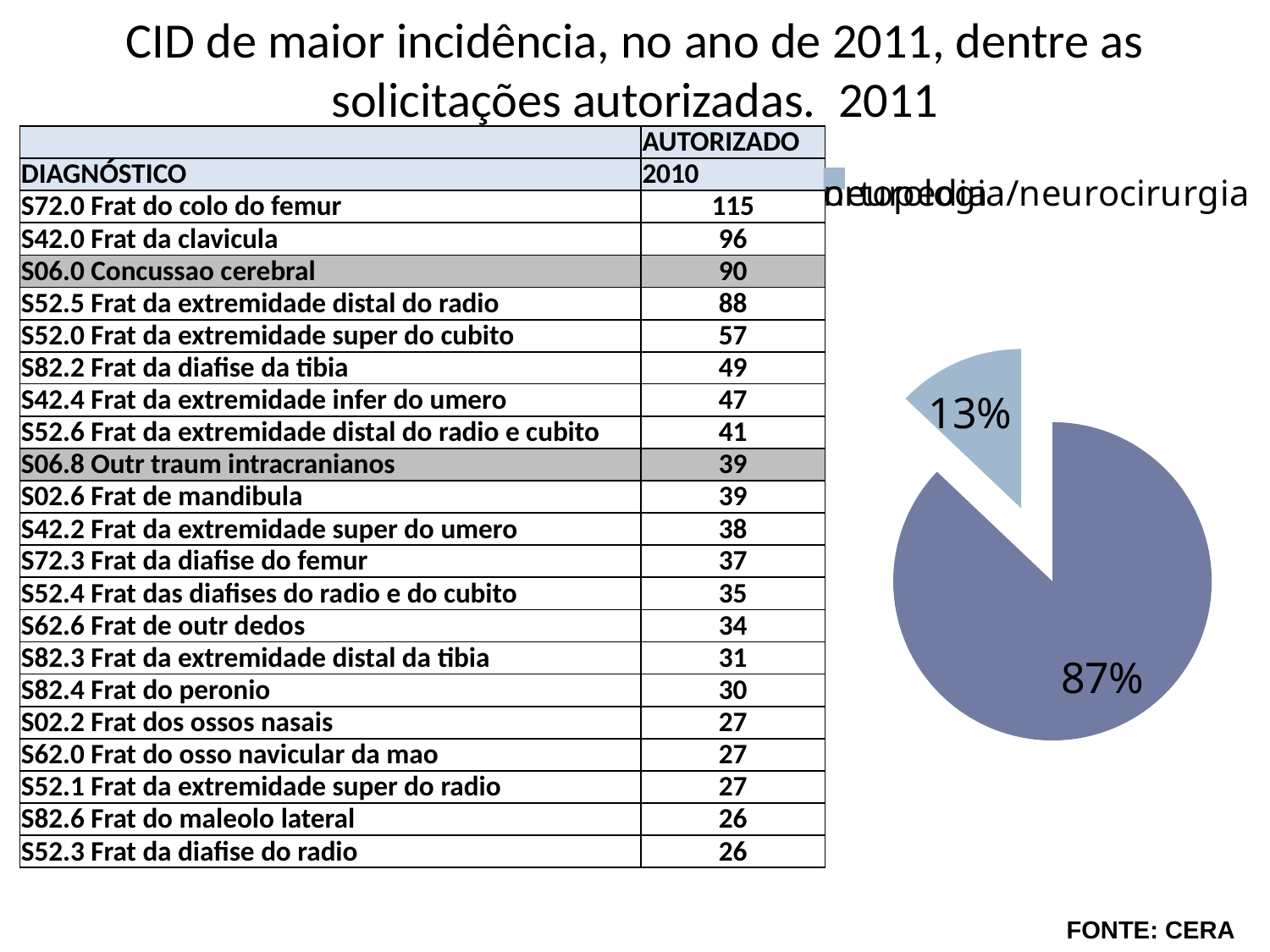
How many slices does the pie chart have? 2 What do the two slices of the pie chart add up to? 100% Which slice of the pie chart is pulled out (exploded) from the rest of the pie? the 13% slice What percentage is shown on the largest slice of the pie chart? 87% What colour is the 13% slice of the pie chart? light blue Which slice of the pie chart is larger, the dark blue one or the light blue one? the dark blue one What value is labelled on the light blue slice of the pie chart? 13% What is the difference in percentage points between the two slices of the pie chart? 74 What percentage is shown on the smallest slice of the pie chart? 13% What kind of chart is shown on the right side of the slide? pie chart Is the share of the dark blue slice in the pie chart greater or less than 50%? greater What value is labelled on the dark blue slice of the pie chart? 87%